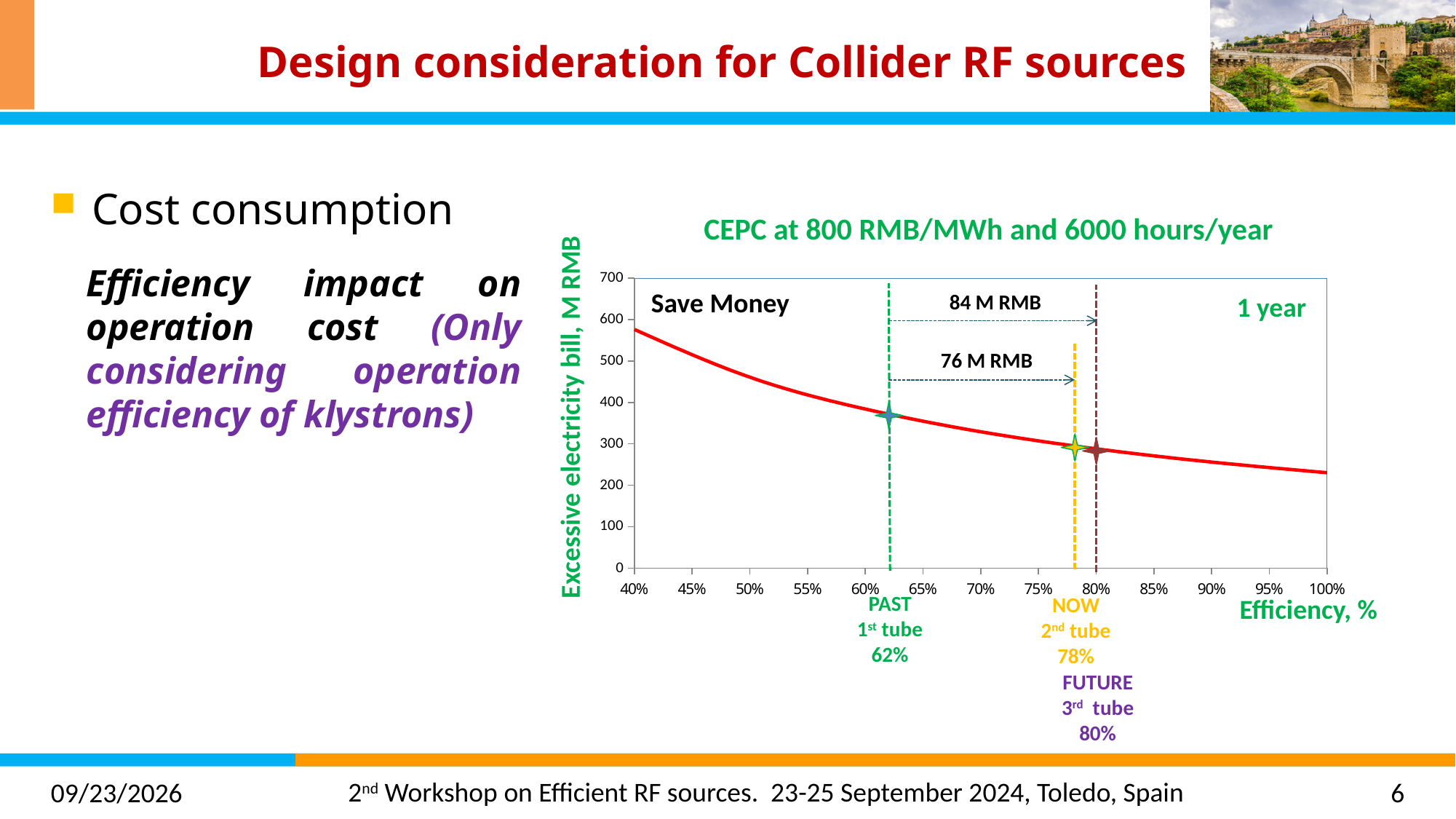
How much money is saved per year by going from the 1st tube (62%) to the 2nd tube (78%)? 76 M RMB What is the efficiency of the 3rd tube (FUTURE) marked on the chart? 80% What is the label of the y axis of the chart? Excessive electricity bill, M RMB How many tubes (PAST, NOW, FUTURE) are marked on the chart? 3 As efficiency increases along the x axis, does the excessive electricity bill rise or fall? fall Is the excessive electricity bill at 62% efficiency greater or less than 300 M RMB? greater How much money is saved per year by going from the 1st tube (62%) to the 3rd tube (80%)? 84 M RMB Is the excessive electricity bill at 40% efficiency greater or less than 500 M RMB? greater What is the efficiency of the 2nd tube (NOW) marked on the chart? 78% What kind of chart is shown on the slide? line chart What is the title of the chart? CEPC at 800 RMB/MWh and 6000 hours/year Which has the larger excessive electricity bill, 62% efficiency or 78% efficiency? 62%